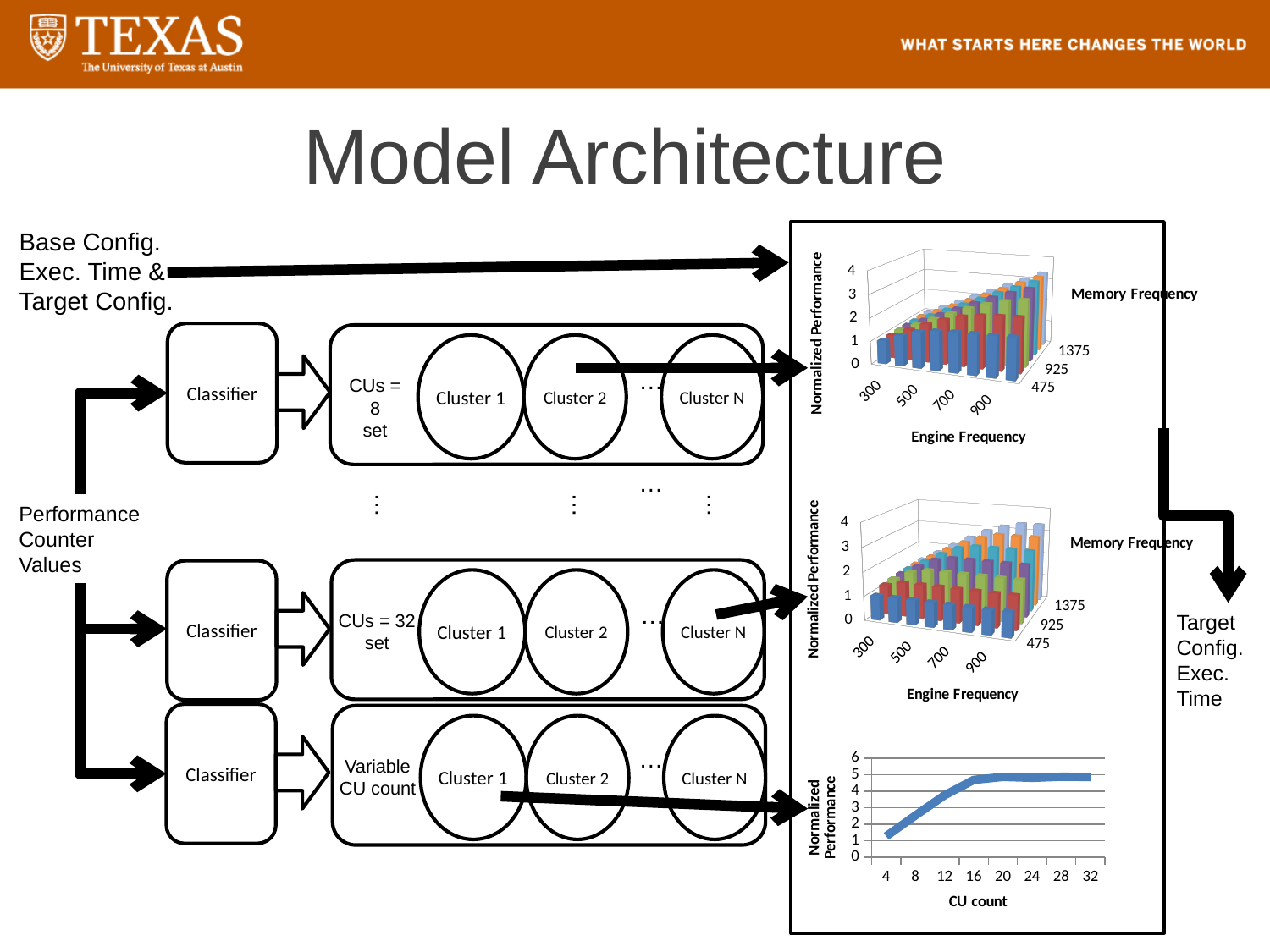
In the bottom chart, which CU count has the higher Normalized Performance, 8 or 16? 16 What is the vertical axis title of the top chart? Normalized Performance In the bottom chart, does Normalized Performance rise or fall as CU count increases from 4 to 16? rise What is the x-axis title of the bottom chart? CU count In the bottom chart, how many CU count tick labels are shown on the x axis? 8 In the top chart, how many Engine Frequency tick labels are shown along the x axis? 4 What kind of chart is the top chart on the slide (the one with Engine Frequency and Memory Frequency axes)? bar chart In the bottom chart, is the Normalized Performance at CU count 16 greater or less than 4? greater What kind of chart is the bottom chart on the slide (the one with CU count on the x axis)? line chart In the bottom chart, is the Normalized Performance at CU count 4 greater or less than 2? less In the bottom chart, is the Normalized Performance at CU count 8 greater or less than 2? greater In the bottom chart, which CU count has the higher Normalized Performance, 4 or 32? 32